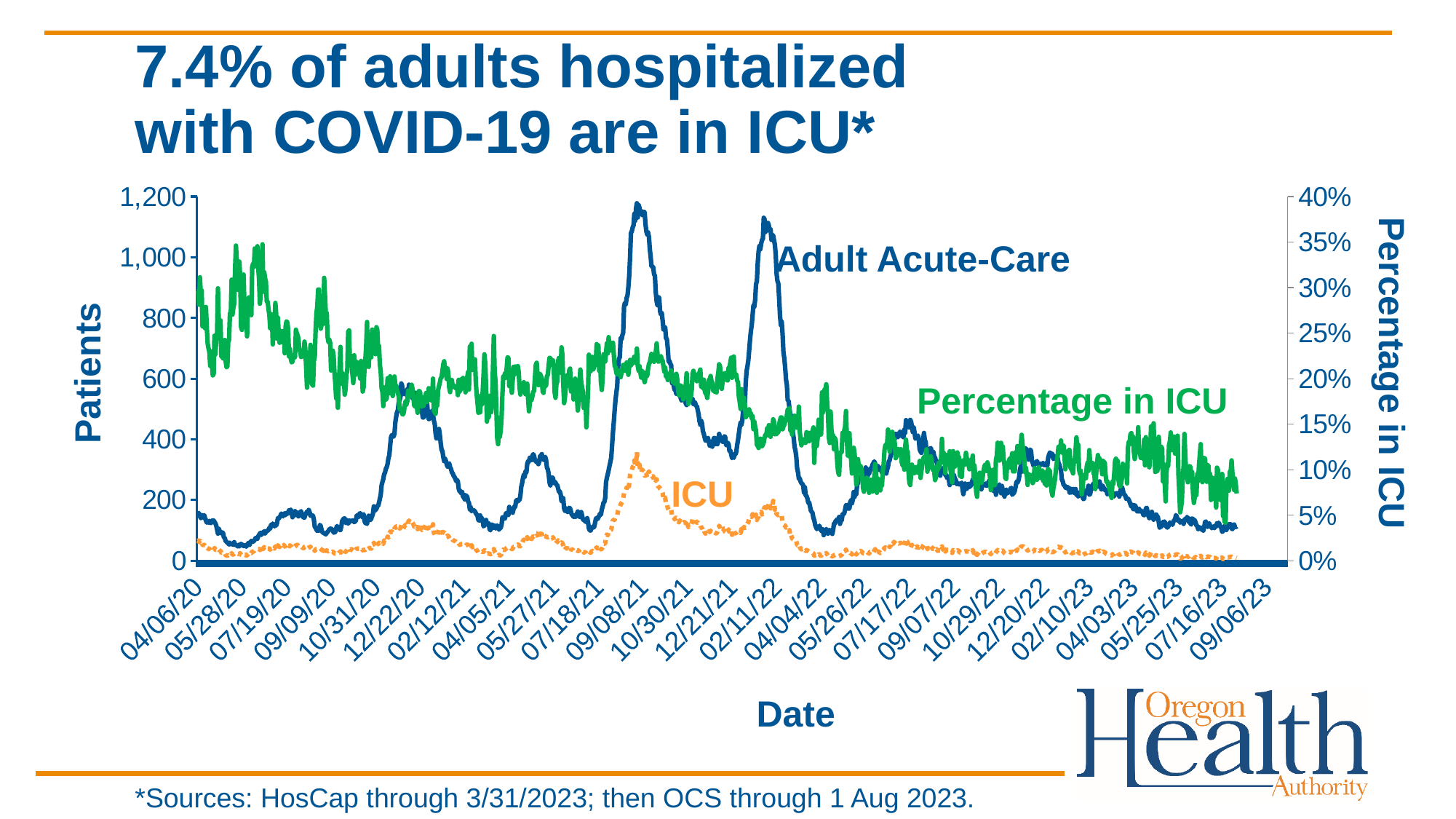
Around 09/08/21, which series has more patients, Adult Acute-Care or ICU? Adult Acute-Care Is the Percentage in ICU at the start of the chart (04/06/20) greater or less than 25%? greater What kind of chart is shown on the slide? Line chart How many data series are plotted on the chart? 3 Is the peak value of Adult Acute-Care around 09/08/21 greater or less than 1,000 patients? greater Is the value for Adult Acute-Care at 04/06/20 greater or less than 200 patients? less Which series reaches the highest number of patients on the chart? Adult Acute-Care What is the label of the left vertical axis? Patients What is the highest value shown on the right vertical axis? 40% Does the Percentage in ICU generally rise or fall from the start of the chart to the end? Fall